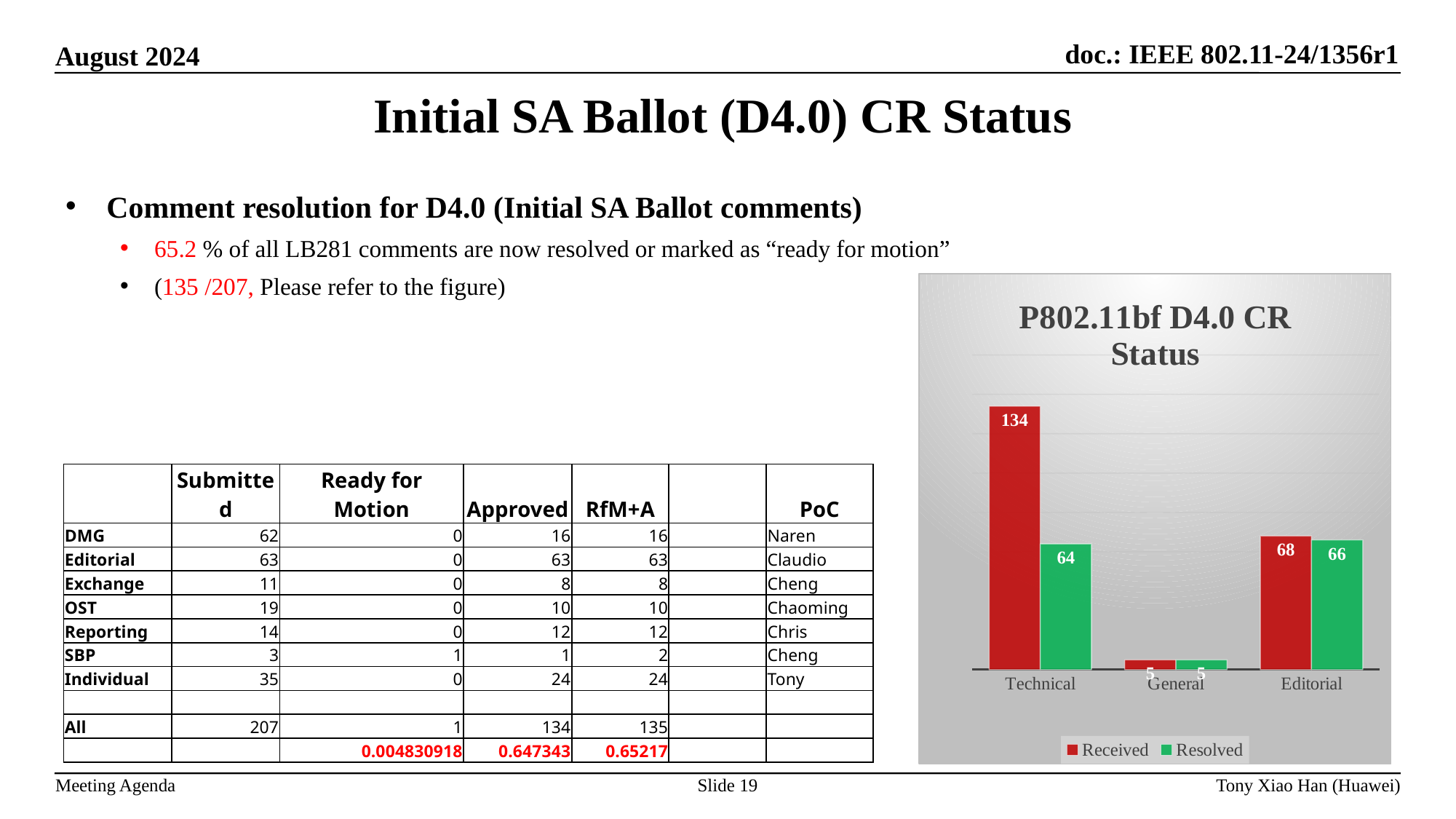
What is the Resolved value for General in the chart? 5 What kind of chart is shown on the slide? bar chart How many series does the chart legend list? 2 What is the Resolved value for Technical in the chart? 64 How many categories are shown on the x axis of the chart? 3 Which category has the highest Received value in the chart? Technical What is the title of the chart on the slide? P802.11bf D4.0 CR Status Which category has the lowest Resolved value in the chart? General What is the difference between the Received and Resolved values for Technical in the chart? 70 What is the Received value for Editorial in the chart? 68 Which is larger in the chart: the Resolved value for Editorial or the Resolved value for Technical? Resolved value for Editorial What is the Received value for Technical in the chart? 134